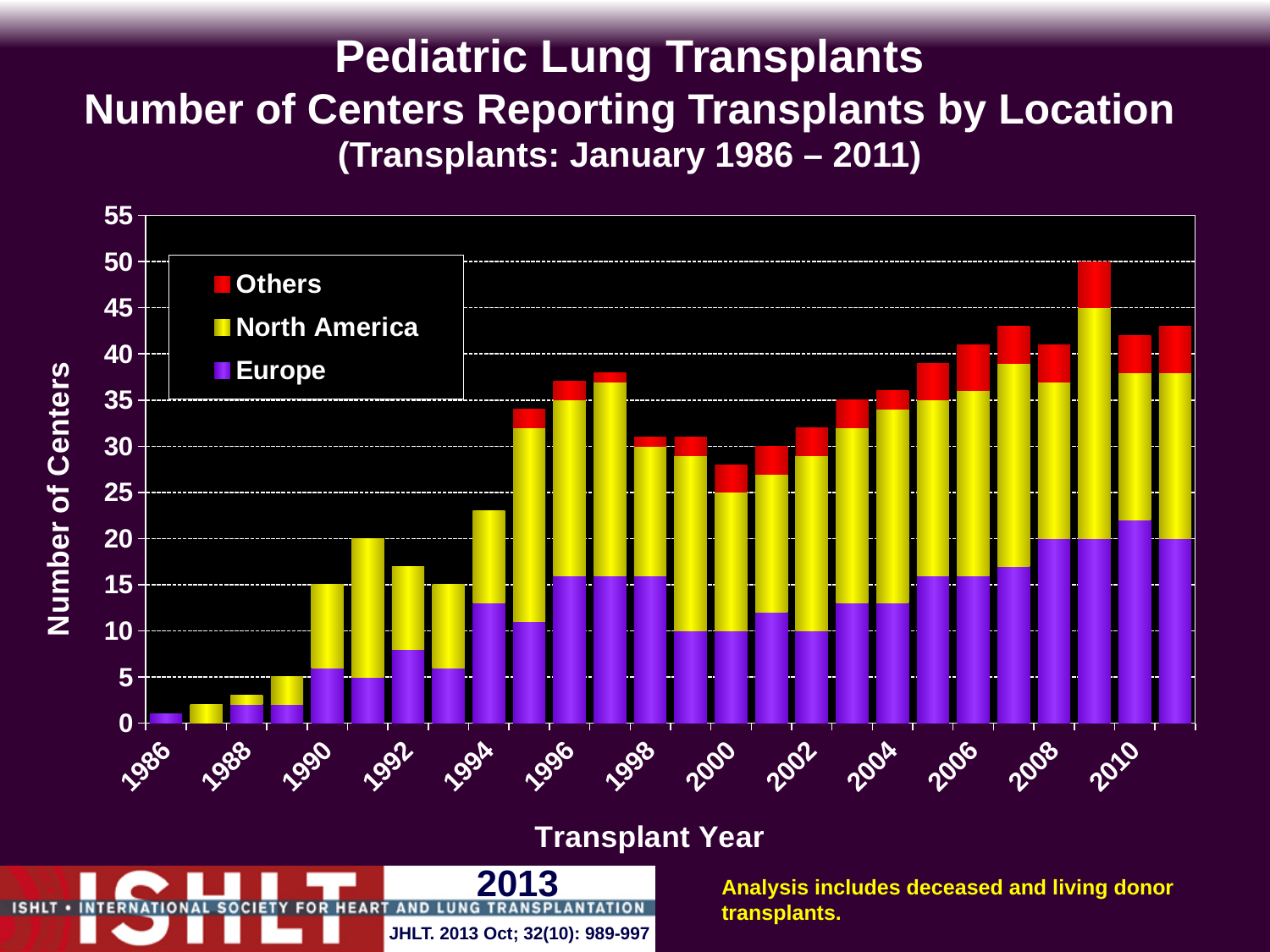
In which transplant year is the total number of centers lowest? 1986 What is the label of the y axis? Number of Centers In which transplant year is the total number of centers highest? 2009 Which year has a larger total number of centers, 1997 or 1998? 1997 Is the total number of centers in 2005 greater or less than 35? greater Is the total number of centers in 2000 greater or less than 30? less What is the total number of centers reporting in 1991? 20 Which series are listed in the legend? Others, North America, Europe How many series does the legend list? 3 What kind of chart is shown on the slide? Stacked bar chart What is the total number of centers reporting in 2009? 50 Overall, do the total number of centers rise or fall from 1986 to 2011? Rise